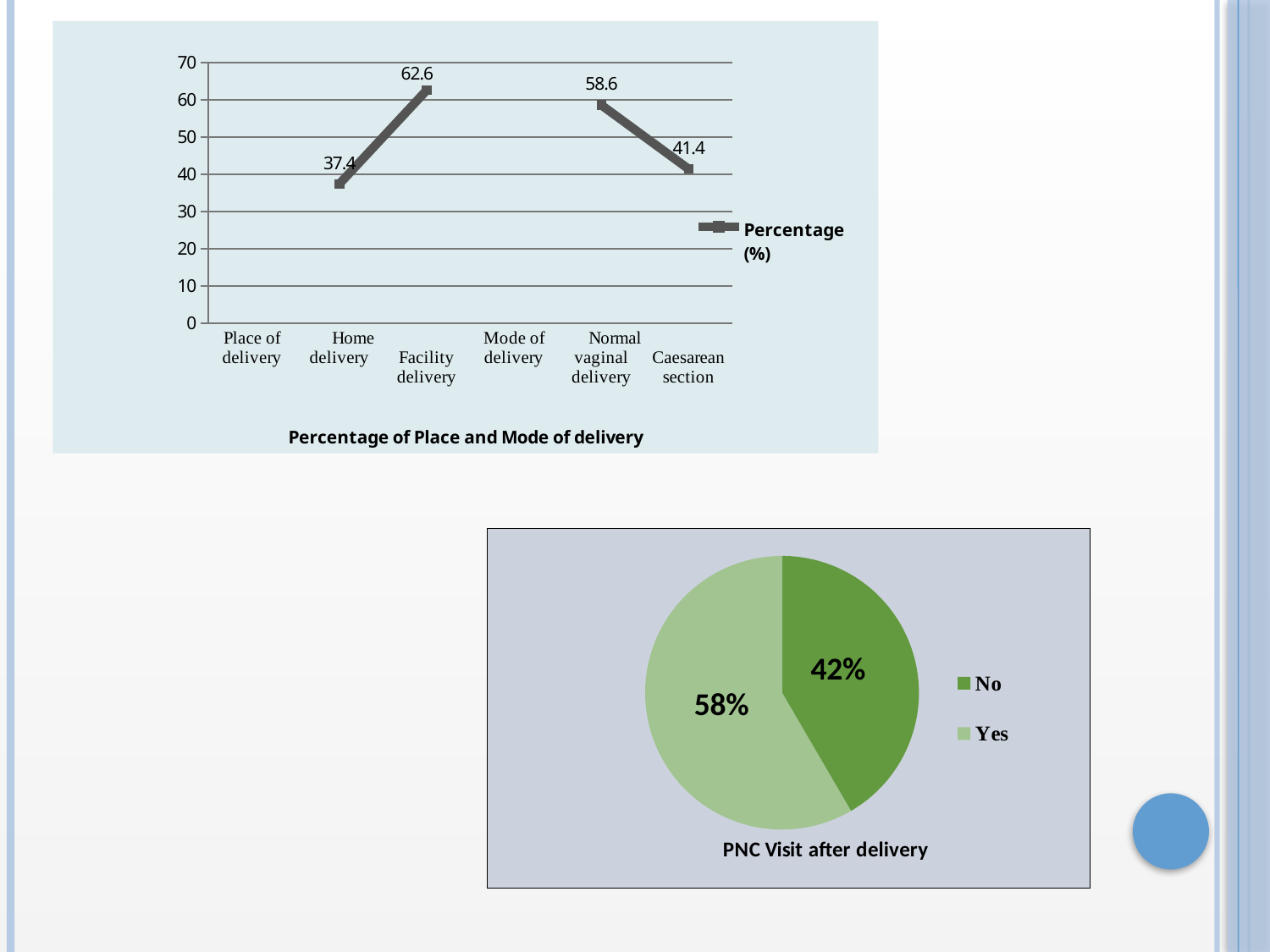
In the 'Percentage of Place and Mode of delivery' chart, what is the value for Caesarean section? 41.4 How many series does the legend of the 'PNC Visit after delivery' pie chart list? 2 In the 'Percentage of Place and Mode of delivery' chart, which is larger: Facility delivery or Normal vaginal delivery? Facility delivery In the 'PNC Visit after delivery' pie chart, what share is labelled No? 42% In the 'Percentage of Place and Mode of delivery' chart, what is the value for Home delivery? 37.4 In the 'Percentage of Place and Mode of delivery' chart, what series does the legend list? Percentage (%) In the 'Percentage of Place and Mode of delivery' chart, what is the value for Facility delivery? 62.6 In the 'PNC Visit after delivery' pie chart, what share is labelled Yes? 58% In the 'Percentage of Place and Mode of delivery' chart, which category has the highest value? Facility delivery In the 'Percentage of Place and Mode of delivery' chart, what is the difference between Normal vaginal delivery and Caesarean section? 17.2 In the 'Percentage of Place and Mode of delivery' chart, which category has the lowest value? Home delivery What kind of chart is the 'PNC Visit after delivery' chart? Pie chart